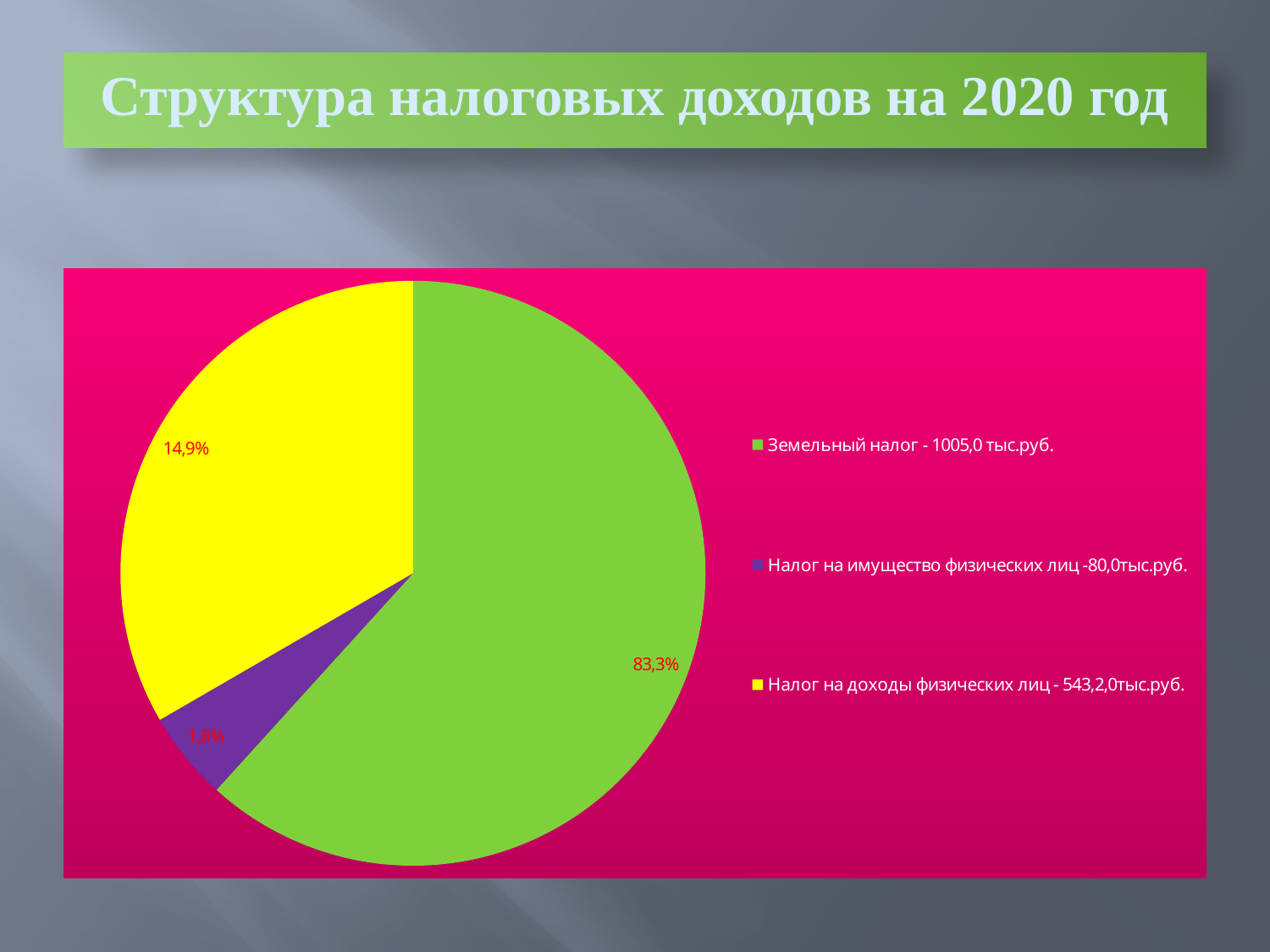
Which is larger: the slice for Земельный налог or the slice for Налог на доходы физических лиц? Земельный налог Which category has the smallest slice of the pie? Налог на имущество физических лиц What is the difference in percentage points between the Земельный налог slice and the Налог на доходы физических лиц slice? 68,4% What share of the pie does Налог на имущество физических лиц take? 1,8% What share of the pie does Налог на доходы физических лиц take? 14,9% Which category has the largest slice of the pie? Земельный налог What kind of chart is shown on the slide? pie chart What is the title of the slide? Структура налоговых доходов на 2020 год What colour is the slice for Налог на доходы физических лиц? yellow How many slices does the pie chart have? 3 What share of the pie does Земельный налог take? 83,3% How many entries does the legend list? 3